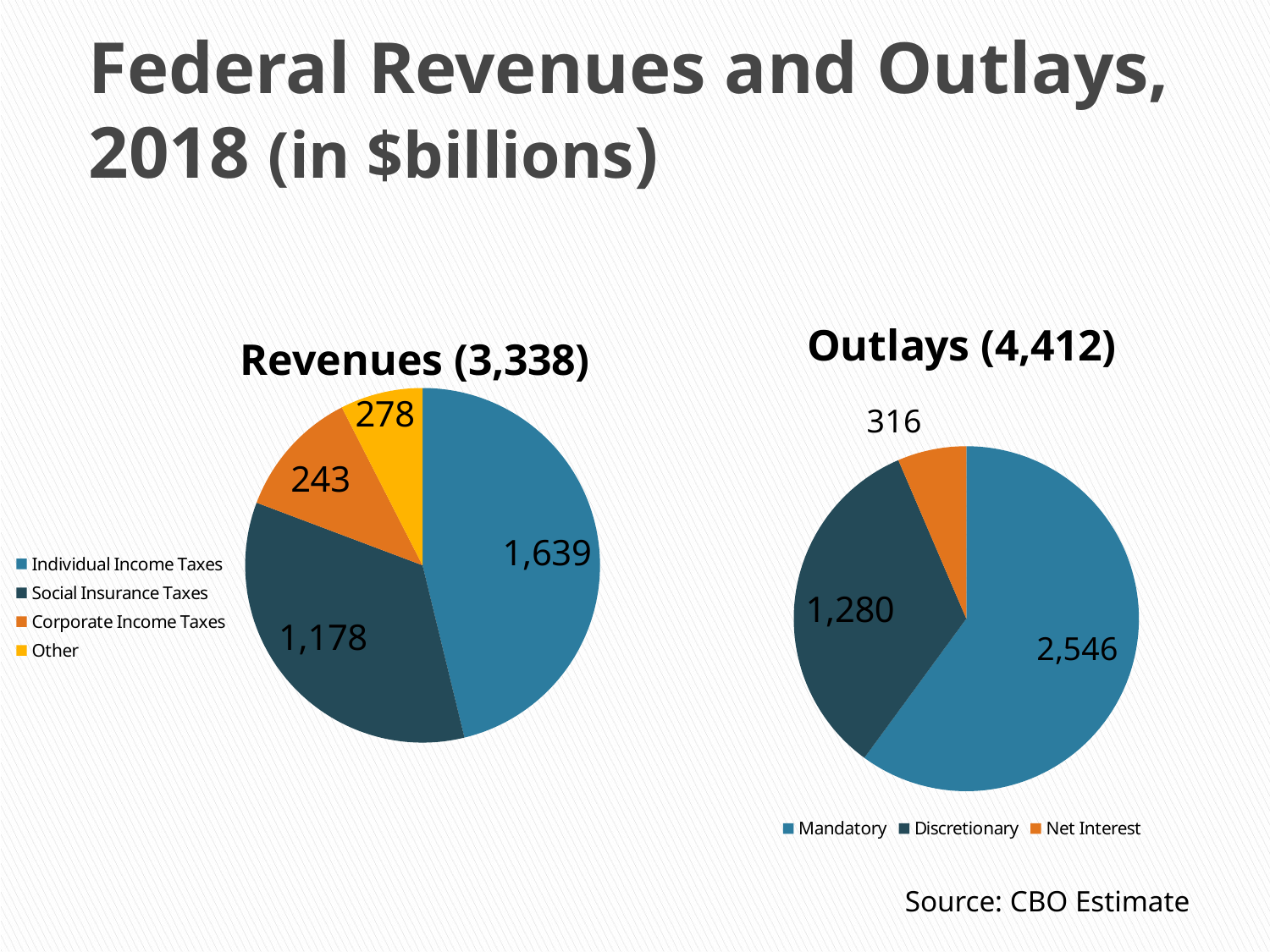
In the Revenues chart, what is the value for Social Insurance Taxes? 1,178 In the Outlays chart, what is the value for Discretionary? 1,280 In the Outlays chart, which category has the largest value? Mandatory How many categories does the Outlays chart show? 3 What kind of chart is the Revenues chart? pie chart In the Revenues chart, what is the difference between Individual Income Taxes and Social Insurance Taxes? 461 In the Revenues chart, what is the value for Corporate Income Taxes? 243 How many entries does the legend of the Revenues chart list? 4 In the Outlays chart, what is the difference between Mandatory and Net Interest? 2,230 In the Revenues chart, what is the value for Individual Income Taxes? 1,639